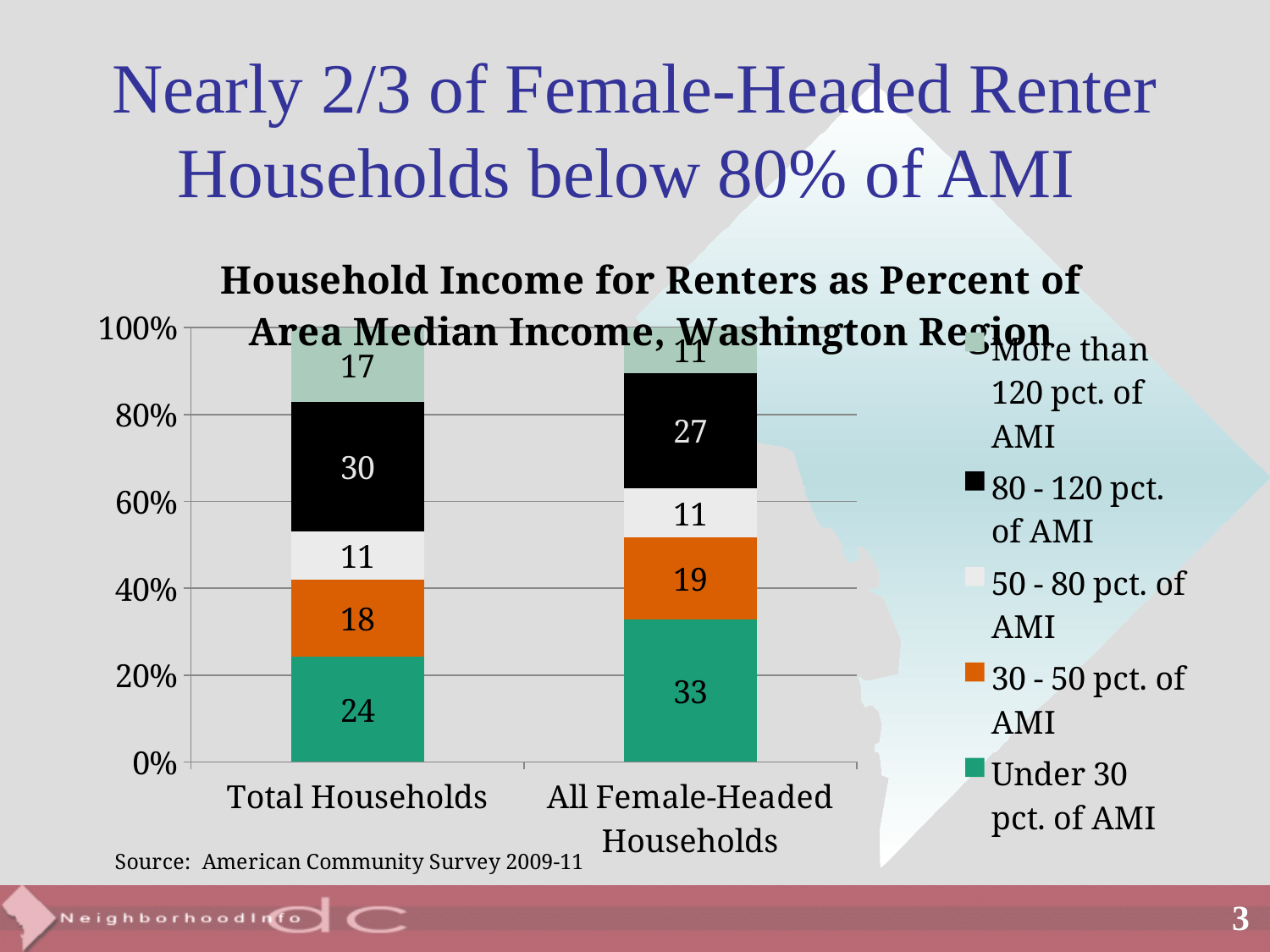
How many categories are shown on the x axis of the chart? 2 What is the difference between the Under 30 pct. of AMI values for All Female-Headed Households and Total Households? 9 What is the value for Under 30 pct. of AMI for Total Households? 24 What is the value for 30 - 50 pct. of AMI for All Female-Headed Households? 19 What is the title of the chart? Household Income for Renters as Percent of Area Median Income, Washington Region What is the value for Under 30 pct. of AMI for All Female-Headed Households? 33 What is the value for More than 120 pct. of AMI for All Female-Headed Households? 11 How many series does the legend list? 5 Which category has the larger value for More than 120 pct. of AMI, Total Households or All Female-Headed Households? Total Households Which segment is the largest in the Total Households bar? 80 - 120 pct. of AMI What is the value for 80 - 120 pct. of AMI for Total Households? 30 What kind of chart is shown on the slide? Stacked bar chart